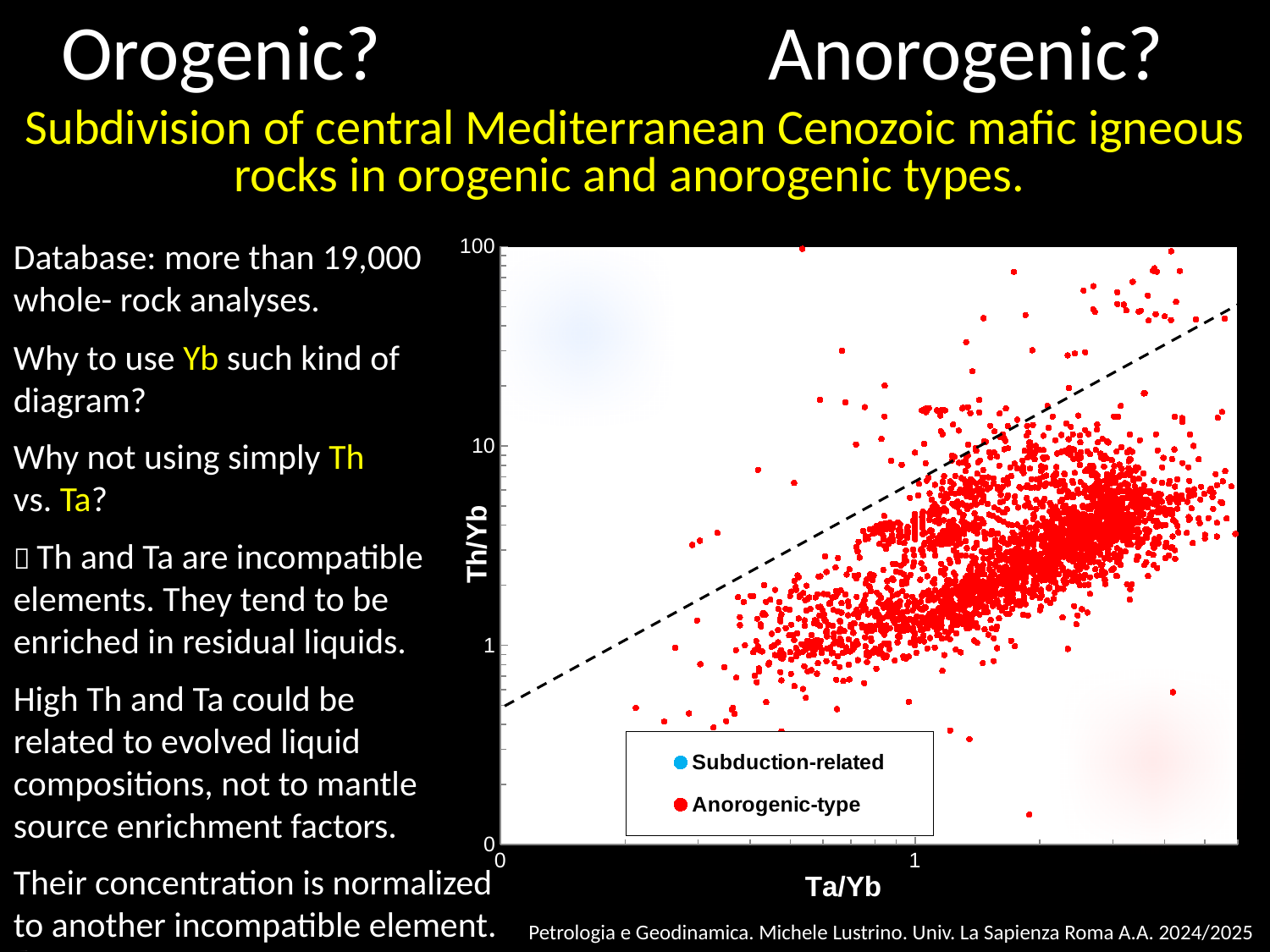
Do the Th/Yb values of the plotted points generally rise or fall as Ta/Yb increases along the x axis? rise How many series does the chart's legend list? 2 What is the label of the x axis of the chart? Ta/Yb What is the label of the y axis of the chart? Th/Yb What is the highest tick value shown on the y axis of the chart? 100 What kind of chart is shown on the slide? scatter plot